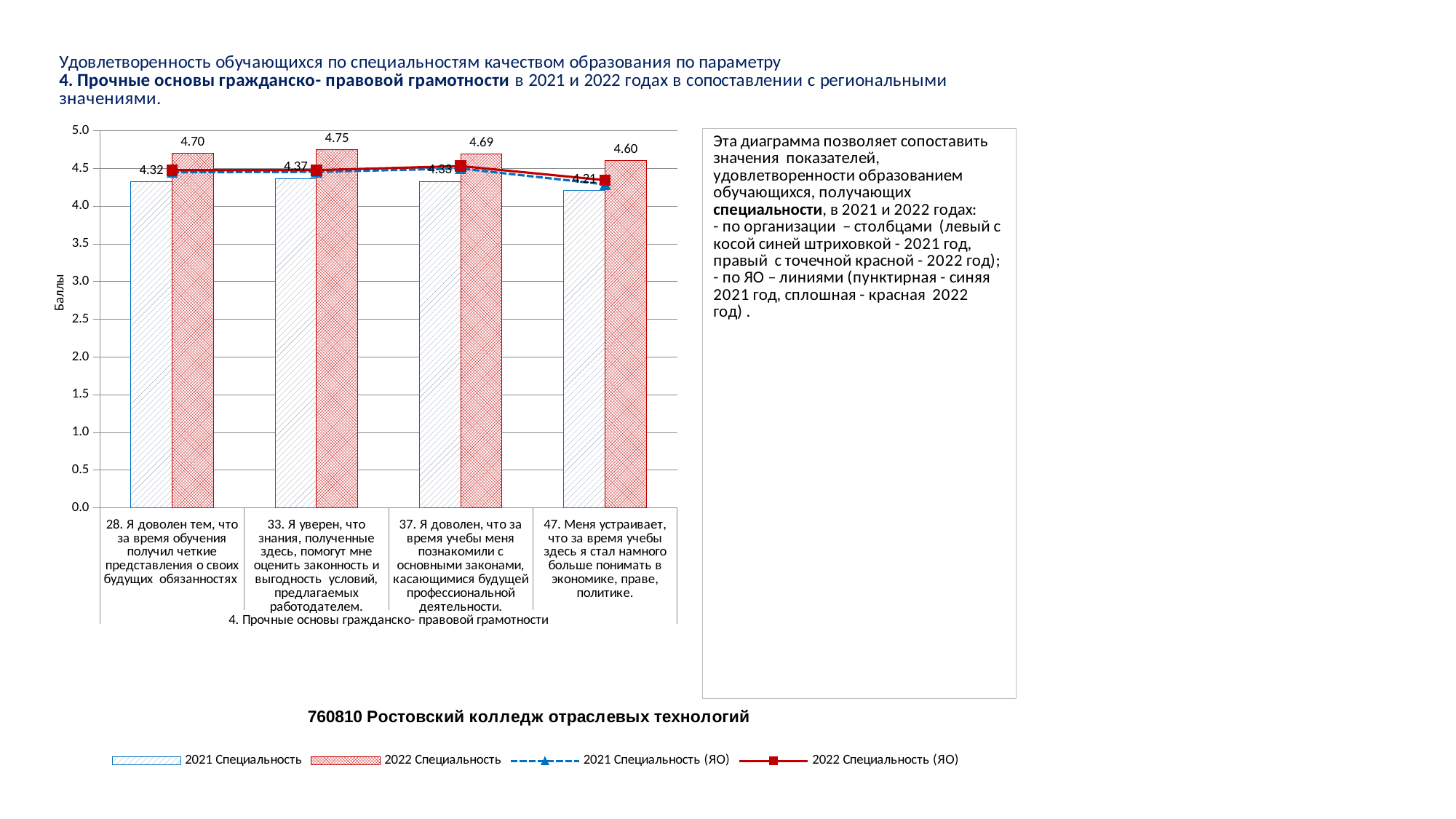
How many questions (categories) are shown on the x axis of the chart? 4 What is the value of the 2022 Специальность bar for question 33 (Я уверен, что знания, полученные здесь, помогут мне оценить законность и выгодность условий, предлагаемых работодателем)? 4.75 How many series does the chart legend list? 4 Is the 2021 Специальность (ЯО) line value for question 47 greater or less than 4.0? greater Which question has the lowest 2021 Специальность bar? 47. Меня устраивает, что за время учебы здесь я стал намного больше понимать в экономике, праве, политике. What is the difference between the 2022 and 2021 Специальность bars for question 47? 0.39 What is the label of the vertical axis of the chart? Баллы What is the value of the 2022 Специальность bar for question 28 (Я доволен тем, что за время обучения получил четкие представления о своих будущих обязанностях)? 4.70 What is the value of the 2021 Специальность bar for question 47 (Меня устраивает, что за время учебы здесь я стал намного больше понимать в экономике, праве, политике)? 4.21 Which is larger for question 37: the 2021 Специальность bar or the 2022 Специальность bar? 2022 Специальность What is the difference between the 2022 Специальность bars for question 33 and question 47? 0.15 Which question has the highest 2022 Специальность bar? 33. Я уверен, что знания, полученные здесь, помогут мне оценить законность и выгодность условий, предлагаемых работодателем.